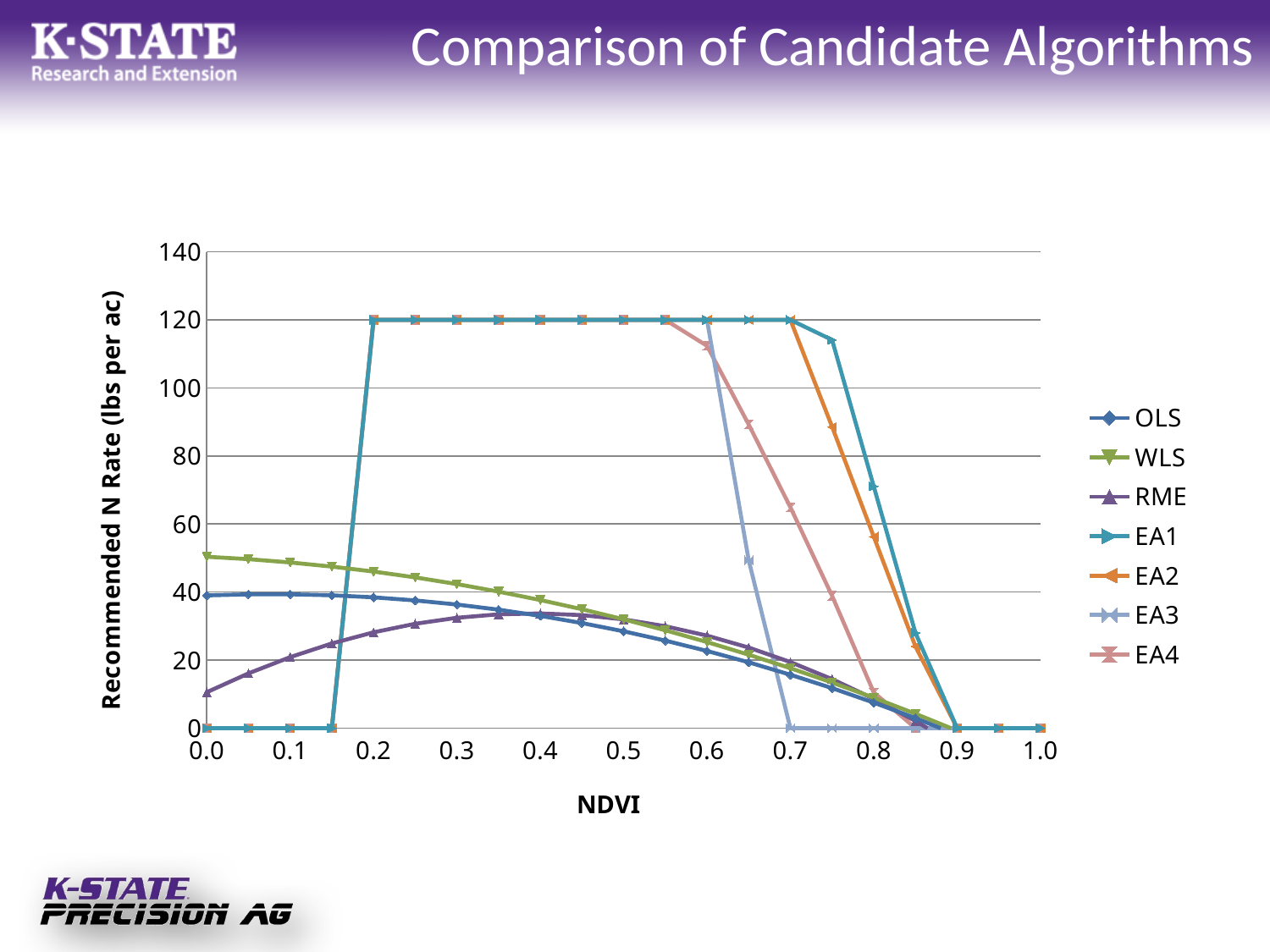
Does the WLS series rise or fall as NDVI increases from 0.0 to 0.9? fall What is the value for EA2 at NDVI 0.1? 0 What is the title of the y axis? Recommended N Rate (lbs per ac) How many series does the legend list? 7 What is the value for EA1 at NDVI 0.5? 120 What kind of chart is shown on the slide? line chart What is the value for EA3 at NDVI 0.7? 0 At NDVI 0.0, which is larger, the value for WLS or the value for OLS? WLS Is the value for RME at NDVI 0.0 greater or less than 20? less Is the value for EA1 at NDVI 0.8 greater or less than 60? greater Is the value for WLS at NDVI 0.0 greater or less than 40? greater Among OLS, WLS and RME, which series has the lowest value at NDVI 0.0? RME